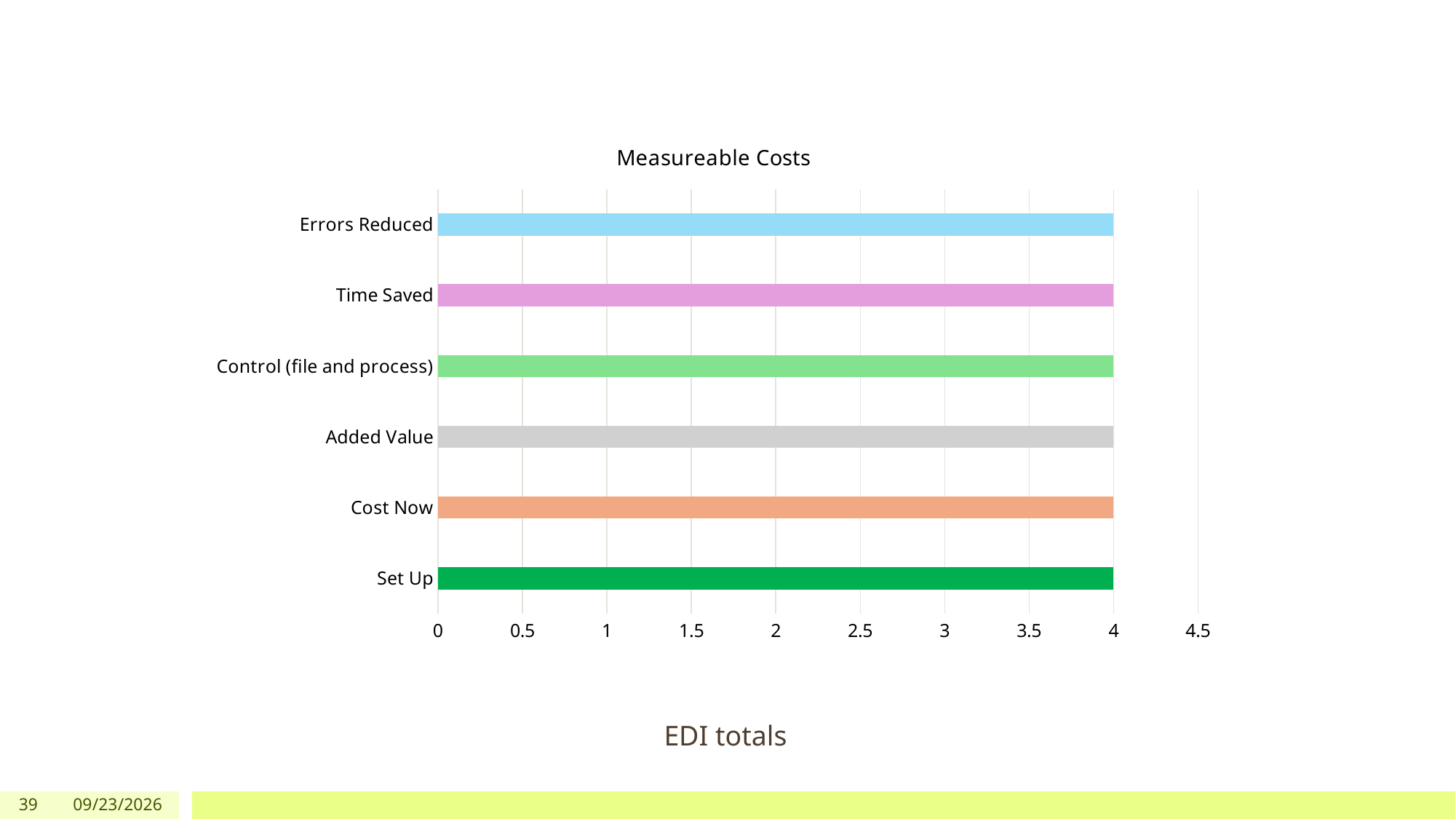
What is the difference between the values for Errors Reduced and Set Up? 0 What is the value for Set Up? 4 What is the highest value shown on the x axis? 4.5 How many categories are plotted in the chart? 6 What is the value for Cost Now? 4 Is the value for Time Saved greater or less than 3? greater What is the value for Errors Reduced? 4 Which category is listed at the top of the chart? Errors Reduced Is the value for Added Value greater or less than 4.5? less What is the title of the chart? Measureable Costs What is the value for Control (file and process)? 4 What type of chart is shown on the slide? bar chart